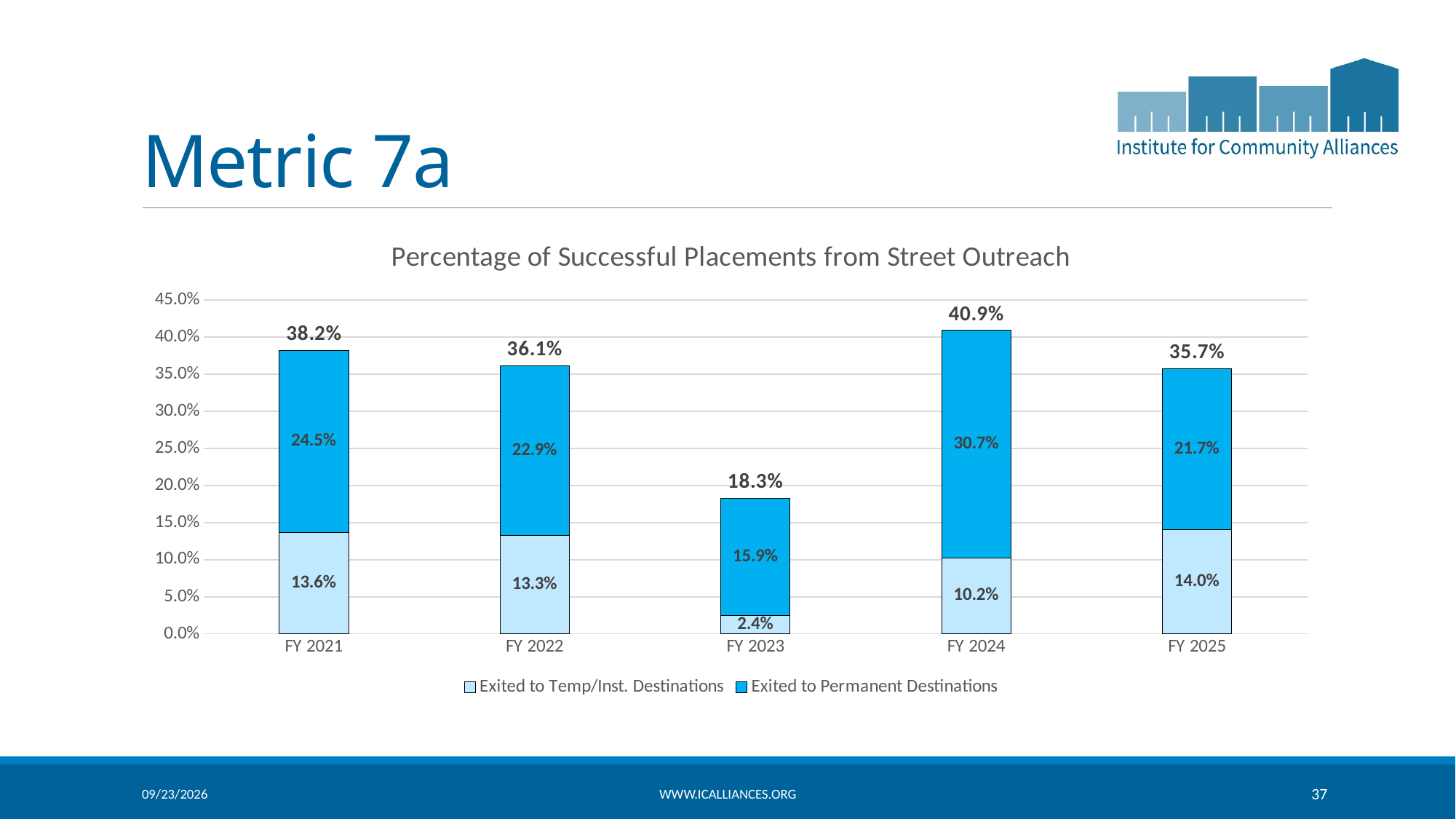
What is the value for Exited to Temp/Inst. Destinations in FY 2023? 2.4% How many series does the legend list? 2 Which fiscal year has the lowest total percentage of successful placements? FY 2023 What is the value for Exited to Permanent Destinations in FY 2024? 30.7% What is the total of the stacked bar for FY 2021? 38.2% Which fiscal year has the highest total percentage of successful placements? FY 2024 What kind of chart is shown on the slide? Stacked bar chart Which is larger, the Exited to Temp/Inst. Destinations value for FY 2021 or for FY 2025? FY 2025 What is the difference between the Exited to Permanent Destinations values for FY 2024 and FY 2025? 9.0% How many fiscal years are shown on the x axis? 5 Is the total for FY 2022 greater or less than 35.0%? greater What is the title of the chart? Percentage of Successful Placements from Street Outreach